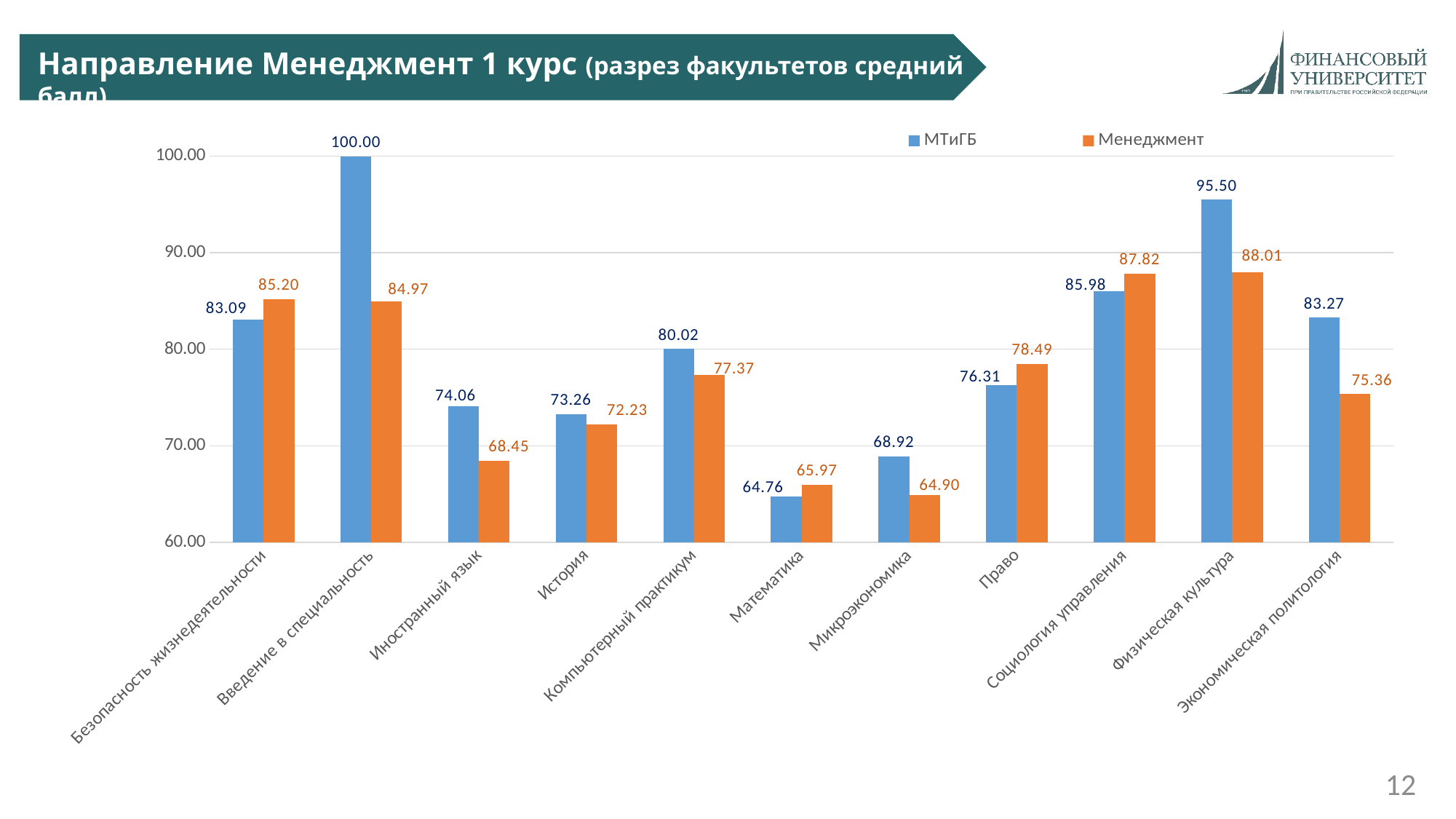
Which category has the highest value for the Менеджмент series? Физическая культура What is the value for МТиГБ in Введение в специальность? 100.00 Which category has the lowest value for the МТиГБ series? Математика How many categories are shown on the x axis? 11 What is the difference between the МТиГБ and Менеджмент values in Экономическая политология? 7.91 What is the value for Менеджмент in Иностранный язык? 68.45 Which is larger in Право: the МТиГБ value or the Менеджмент value? Менеджмент What kind of chart is shown on the slide? bar chart Which colour represents the Менеджмент series? orange What is the value for Менеджмент in Физическая культура? 88.01 Is the value for МТиГБ in Социология управления greater or less than 90.00? less How many series does the legend list? 2